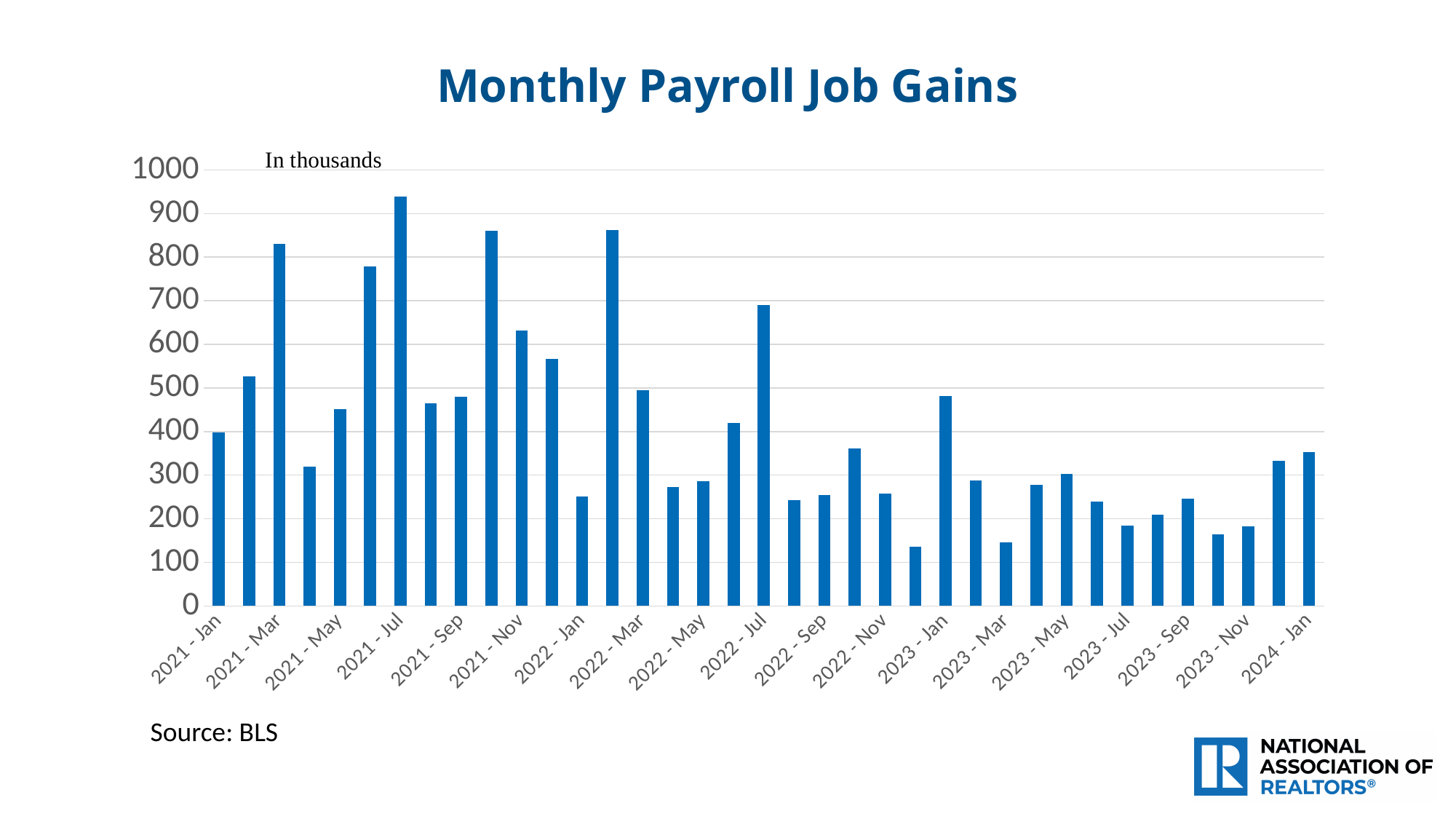
Which is larger, the value for 2023 - Jan or the value for 2023 - Mar? 2023 - Jan Which is larger, the value for 2022 - Mar or the value for 2022 - May? 2022 - Mar In what units are the values on the chart expressed? In thousands Is the value for 2021 - Mar greater or less than 800? greater Which is larger, the value for 2021 - Jul or the value for 2021 - Nov? 2021 - Jul Which month has the highest monthly payroll job gains? 2021 - Jul Is the value for 2022 - Jan greater or less than 300? less Is the value for 2023 - Mar greater or less than 200? less What kind of chart is shown on the slide? bar chart Do monthly payroll job gains generally rise or fall from 2021 to 2023? fall